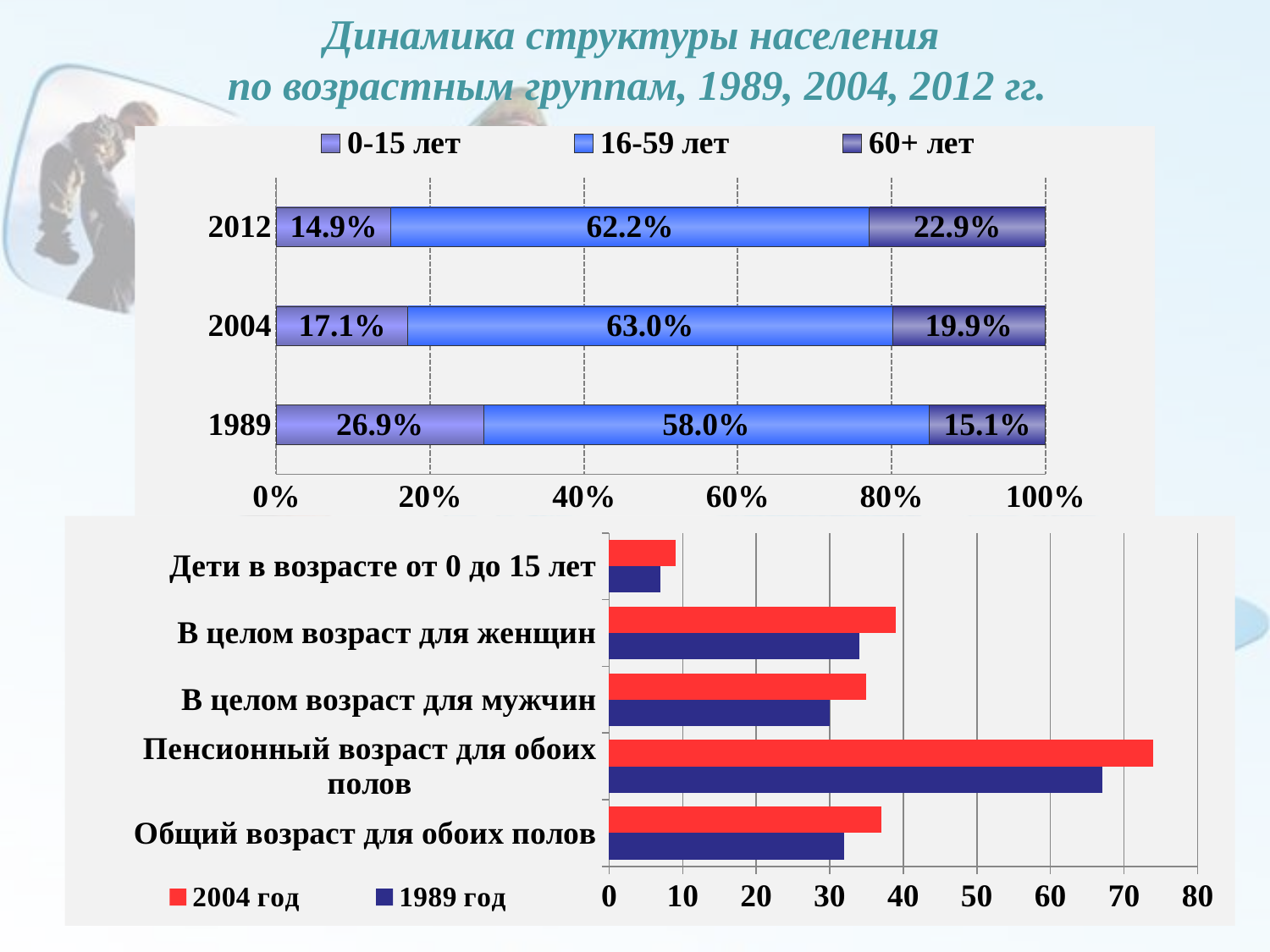
In the top chart, how many series does the legend list? 3 In the top chart, what is the value for 0-15 лет in 2012? 14.9% In the top chart, does the share of 0-15 лет rise or fall from 1989 to 2012? fall In the bottom chart, how many categories are shown? 5 In the top chart, which year has the highest value for 60+ лет? 2012 In the bottom chart, which is larger for Пенсионный возраст для обоих полов: 2004 год or 1989 год? 2004 год What kind of chart is the bottom chart? bar chart In the bottom chart, is the value for Дети в возрасте от 0 до 15 лет in 1989 год greater or less than 20? less In the top chart, what is the value for 60+ лет in 2004? 19.9% In the top chart, what is the value for 16-59 лет in 1989? 58.0% In the top chart, what is the difference between the 0-15 лет values for 1989 and 2012? 12.0% In the bottom chart, is the value for Пенсионный возраст для обоих полов in 2004 год greater or less than 70? greater